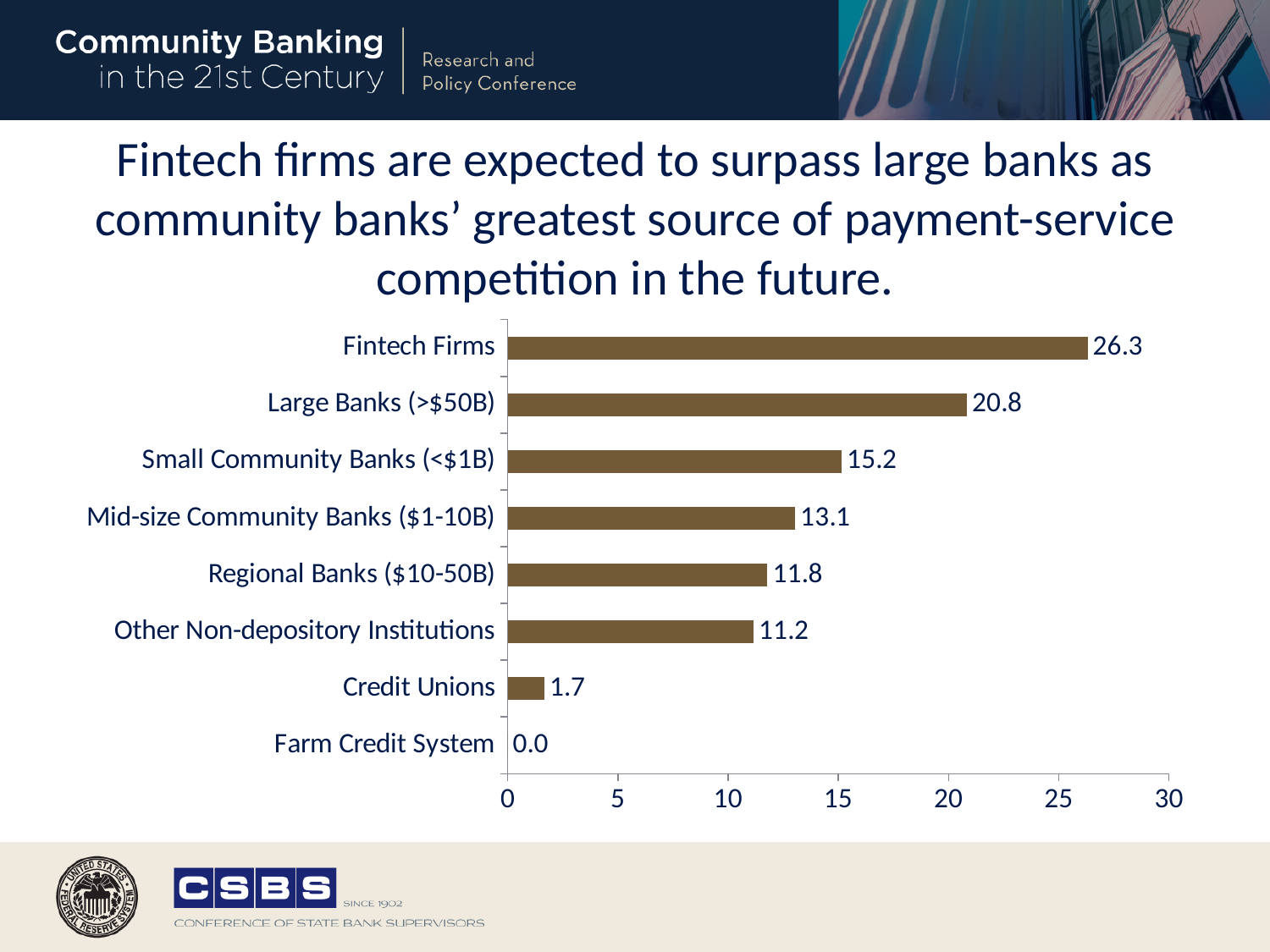
What kind of chart is shown on the slide? bar chart Which category has the lowest value? Farm Credit System How many categories are shown in the chart? 8 What is the maximum value shown on the horizontal axis? 30 What is the value for Credit Unions? 1.7 What is the value for Other Non-depository Institutions? 11.2 What is the difference between the values for Fintech Firms and Large Banks (>$50B)? 5.5 Which is larger, the value for Small Community Banks (<$1B) or Regional Banks ($10-50B)? Small Community Banks (<$1B) What is the value for Fintech Firms? 26.3 Which category has the highest value? Fintech Firms Is the value for Mid-size Community Banks ($1-10B) greater or less than 10? greater What is the value for Large Banks (>$50B)? 20.8